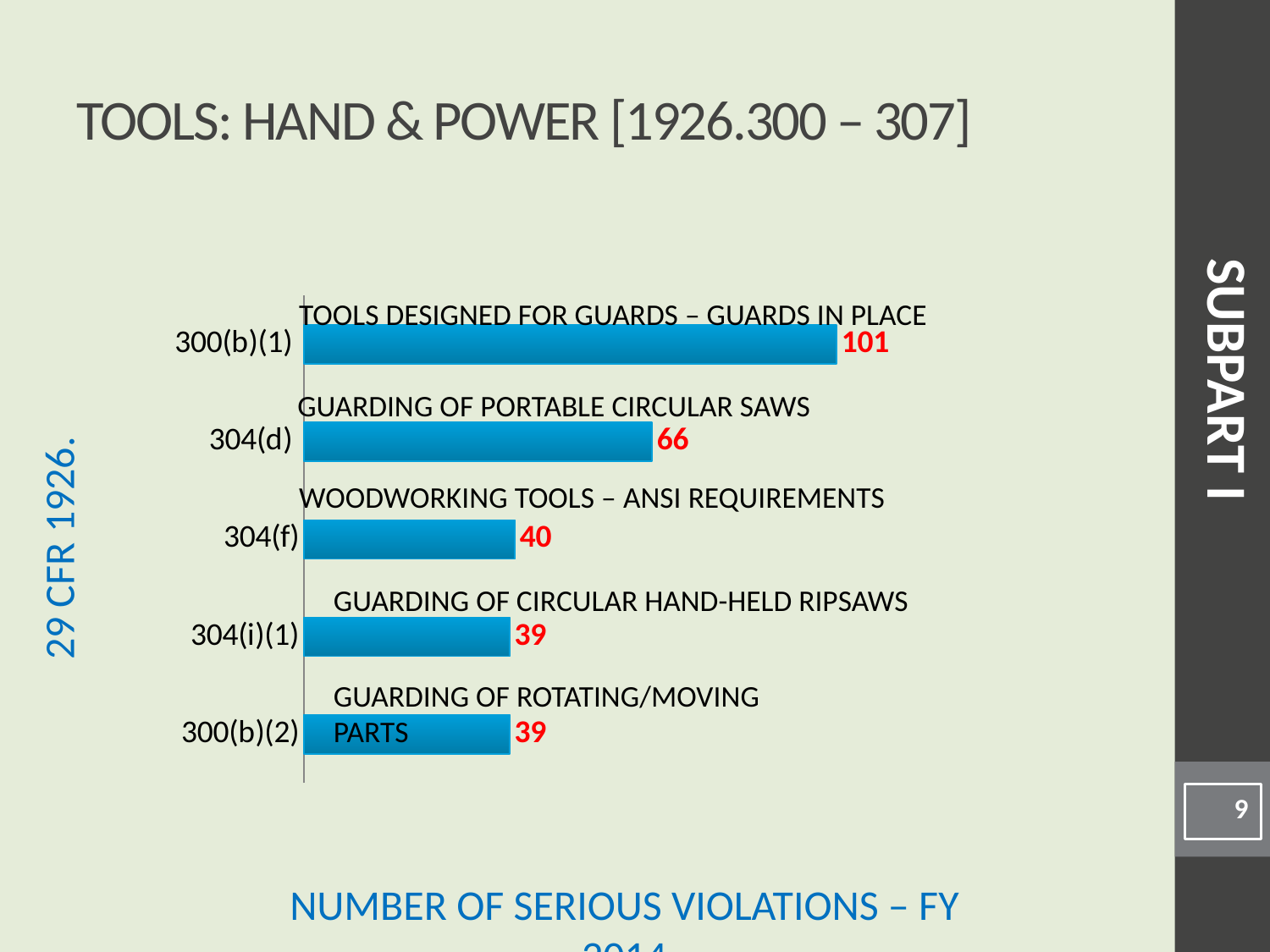
How many standards are shown in the chart? 5 What is the number of serious violations for 304(d)? 66 What kind of chart is shown on the slide? Bar chart What is the number of serious violations for 304(f)? 40 What is the number of serious violations for 300(b)(1)? 101 What is the number of serious violations for 304(i)(1)? 39 What is the difference in serious violations between 300(b)(1) and 304(d)? 35 What is the difference in serious violations between 304(d) and 304(f)? 26 What is the number of serious violations for 300(b)(2)? 39 Which standard has the highest number of serious violations? 300(b)(1) Which standard is described as 'GUARDING OF PORTABLE CIRCULAR SAWS'? 304(d) Which has more serious violations, 304(d) or 304(f)? 304(d)